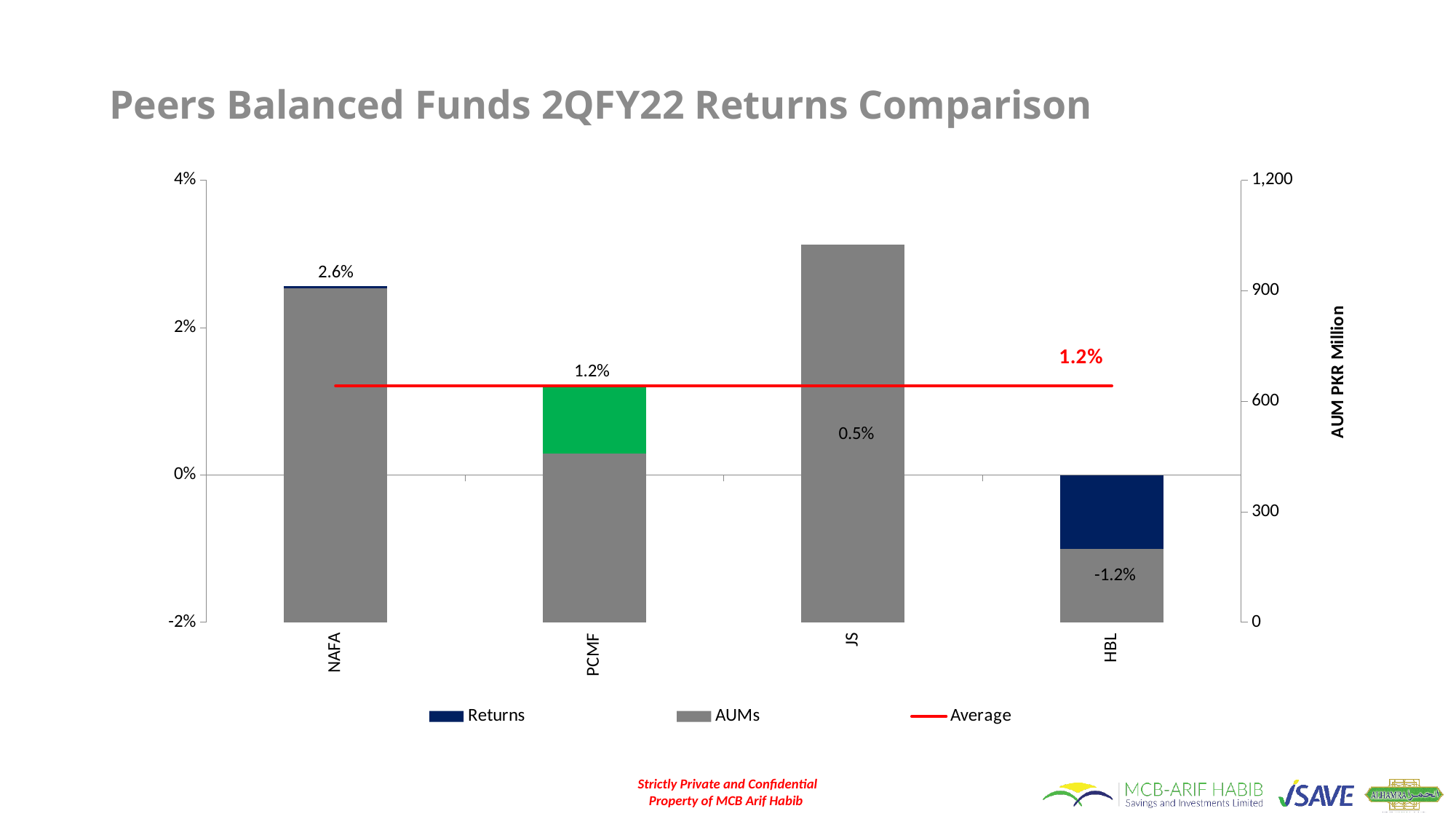
What is the return shown for HBL? -1.2% What value is shown for the Average line? 1.2% Which fund has the largest AUM bar? JS What is the difference in percentage points between the NAFA return and the JS return? 2.1 percentage points What is the return shown for JS? 0.5% Is the AUM for HBL greater or less than 300 PKR Million? less What is the return shown for NAFA? 2.6% Which fund has the smallest AUM bar? HBL Which fund has the highest return? NAFA Which fund has the lowest return? HBL How many series does the legend list? 3 Is the AUM for JS greater or less than 900 PKR Million? greater